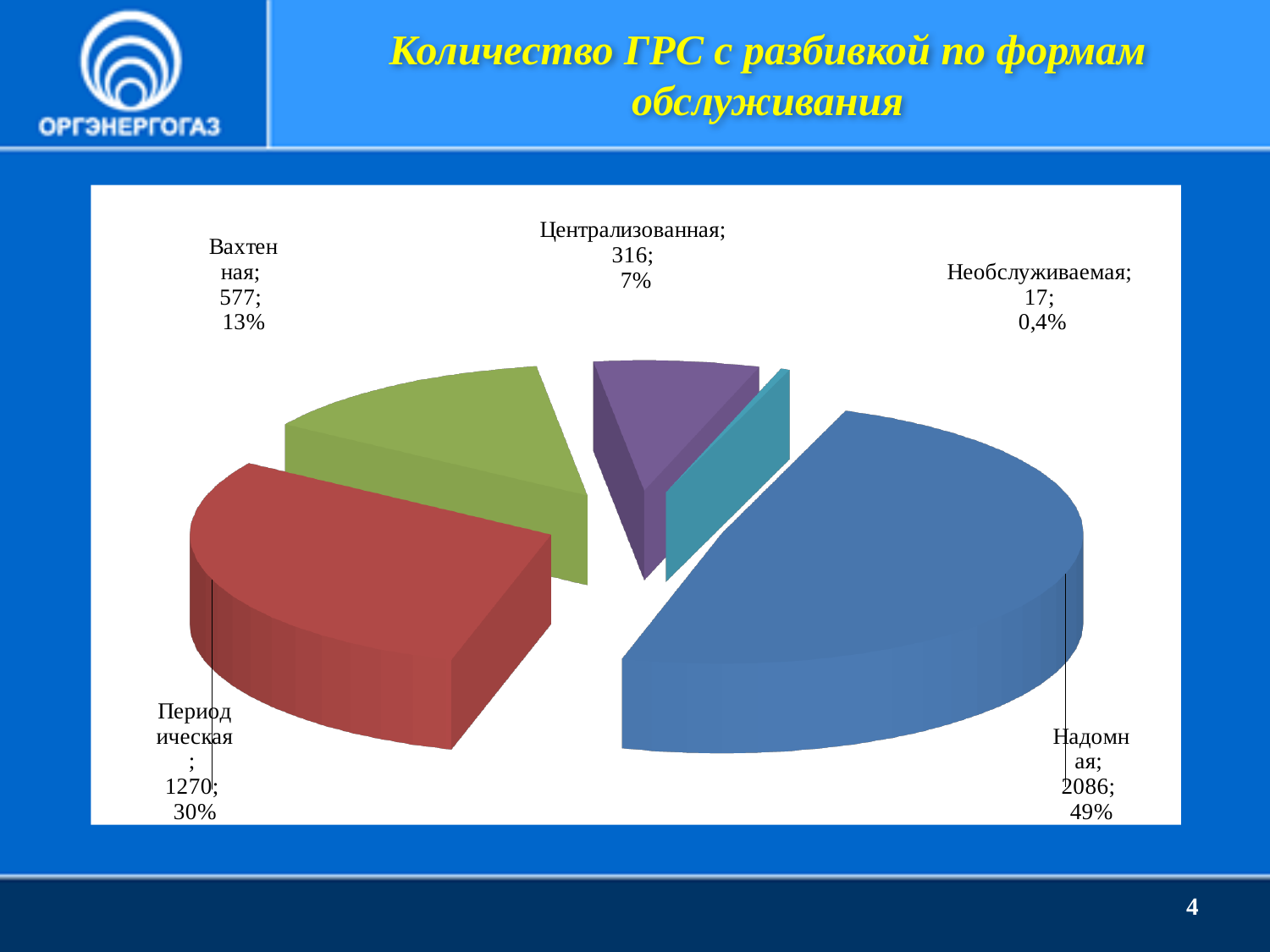
What is the value for Централизованная? 316 What is the value for Периодическая? 1270 What share of the pie does Централизованная represent? 7% What is the value for Надомная? 2086 What is the value for Необслуживаемая? 17 What type of chart is shown on the slide? Pie chart What is the value for Вахтенная? 577 What is the difference between the values for Надомная and Периодическая? 816 Which category has the largest slice of the pie? Надомная What share of the pie does Периодическая represent? 30% Which category has the smallest slice of the pie? Необслуживаемая How many categories are shown in the pie chart? 5